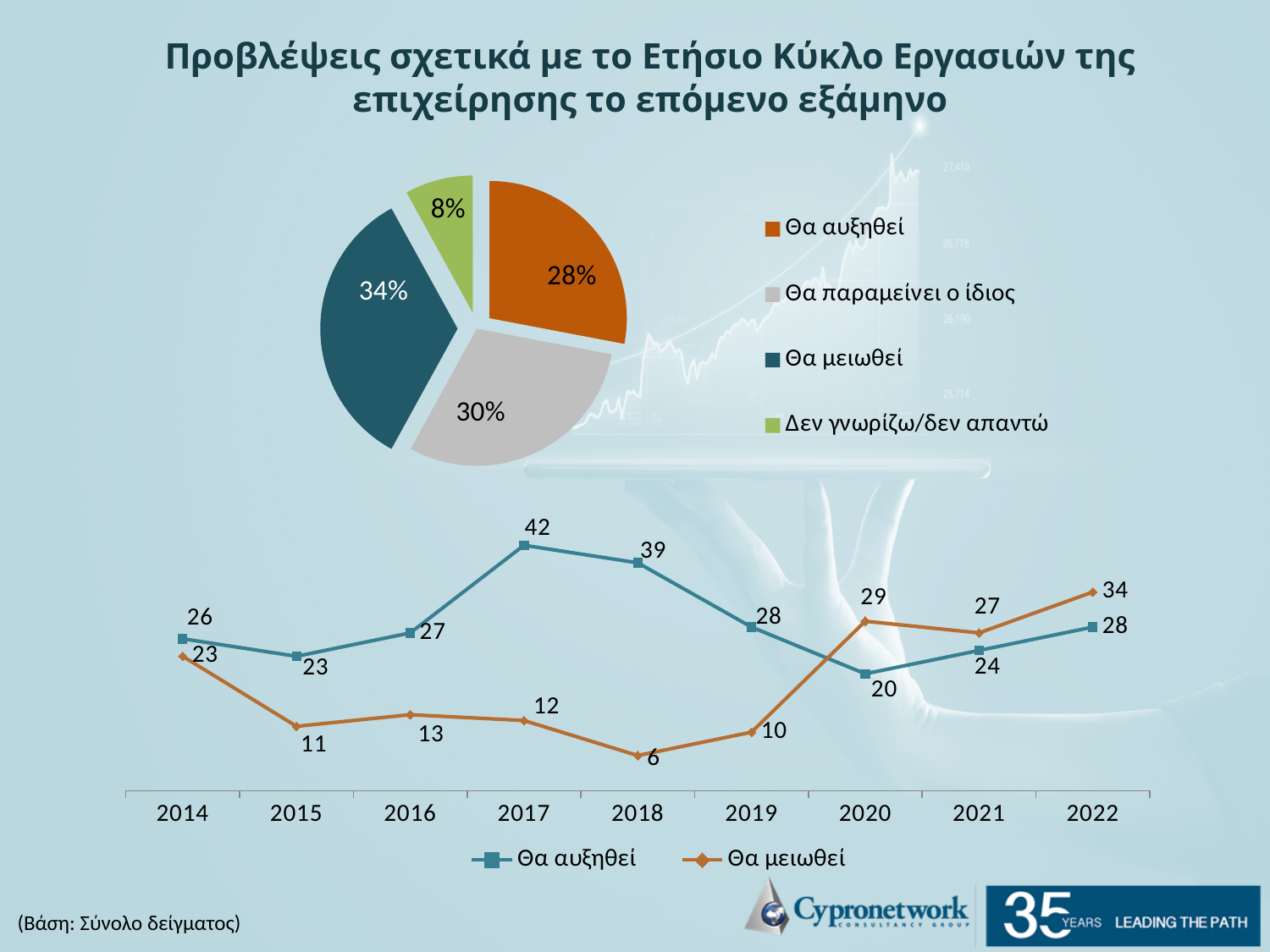
In the pie chart, what share is shown for "Θα μειωθεί"? 34% In the line chart at the bottom, what is the value for "Θα μειωθεί" in 2018? 6 In the line chart at the bottom, in which year does "Θα μειωθεί" reach its lowest value? 2018 In the line chart at the bottom, what is the difference between "Θα αυξηθεί" and "Θα μειωθεί" in 2022? 6 In the pie chart, which category has the largest slice? Θα μειωθεί In the line chart at the bottom, in which year does "Θα αυξηθεί" reach its highest value? 2017 In the pie chart, which category has the smallest slice? Δεν γνωρίζω/δεν απαντώ In the pie chart, what is the difference between the shares for "Θα παραμείνει ο ίδιος" and "Θα αυξηθεί"? 2% In the line chart at the bottom, what is the value for "Θα αυξηθεί" in 2017? 42 In the line chart at the bottom, how many years are shown on the x axis? 9 In the pie chart, how many categories does the legend list? 4 In the line chart at the bottom, which series has the higher value in 2020, "Θα αυξηθεί" or "Θα μειωθεί"? Θα μειωθεί